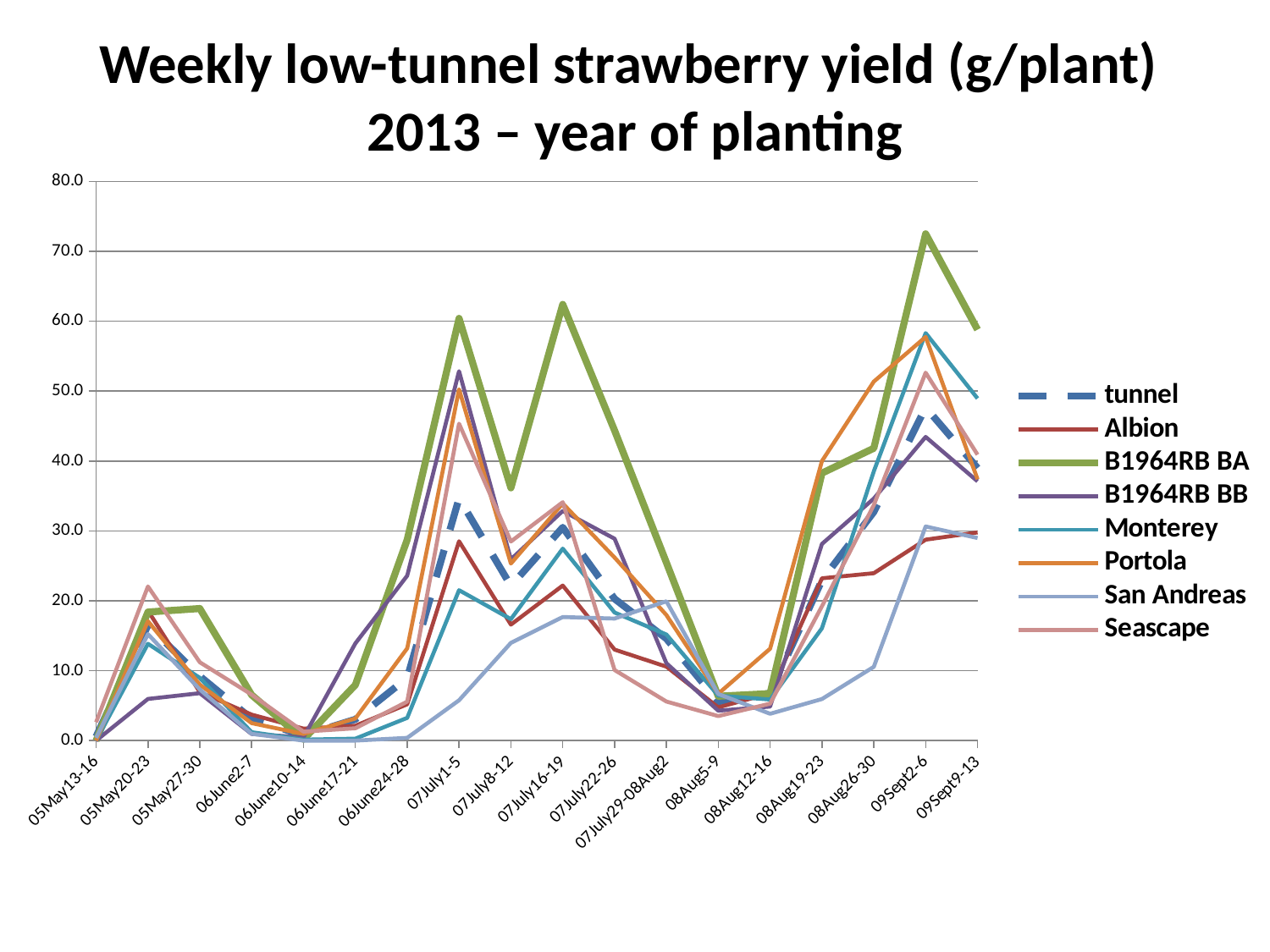
How many series does the legend list? 8 Is the value for B1964RB BA at 09Sept2-6 greater or less than 60.0? greater Which series reaches the highest yield anywhere on the chart? B1964RB BA At 08Aug26-30, which is larger: Portola or Albion? Portola Which series has the highest value at 09Sept2-6? B1964RB BA Is the value for San Andreas at 07July1-5 greater or less than 10.0? less How many weekly periods are shown along the x axis? 18 Which series has the lowest value at 07July1-5? San Andreas Is the value for Albion at 09Sept9-13 greater or less than 40.0? less Does the B1964RB BA line rise or fall from 08Aug12-16 to 09Sept2-6? rises What kind of chart is shown on the slide? line chart Which series is drawn with a dashed line? tunnel